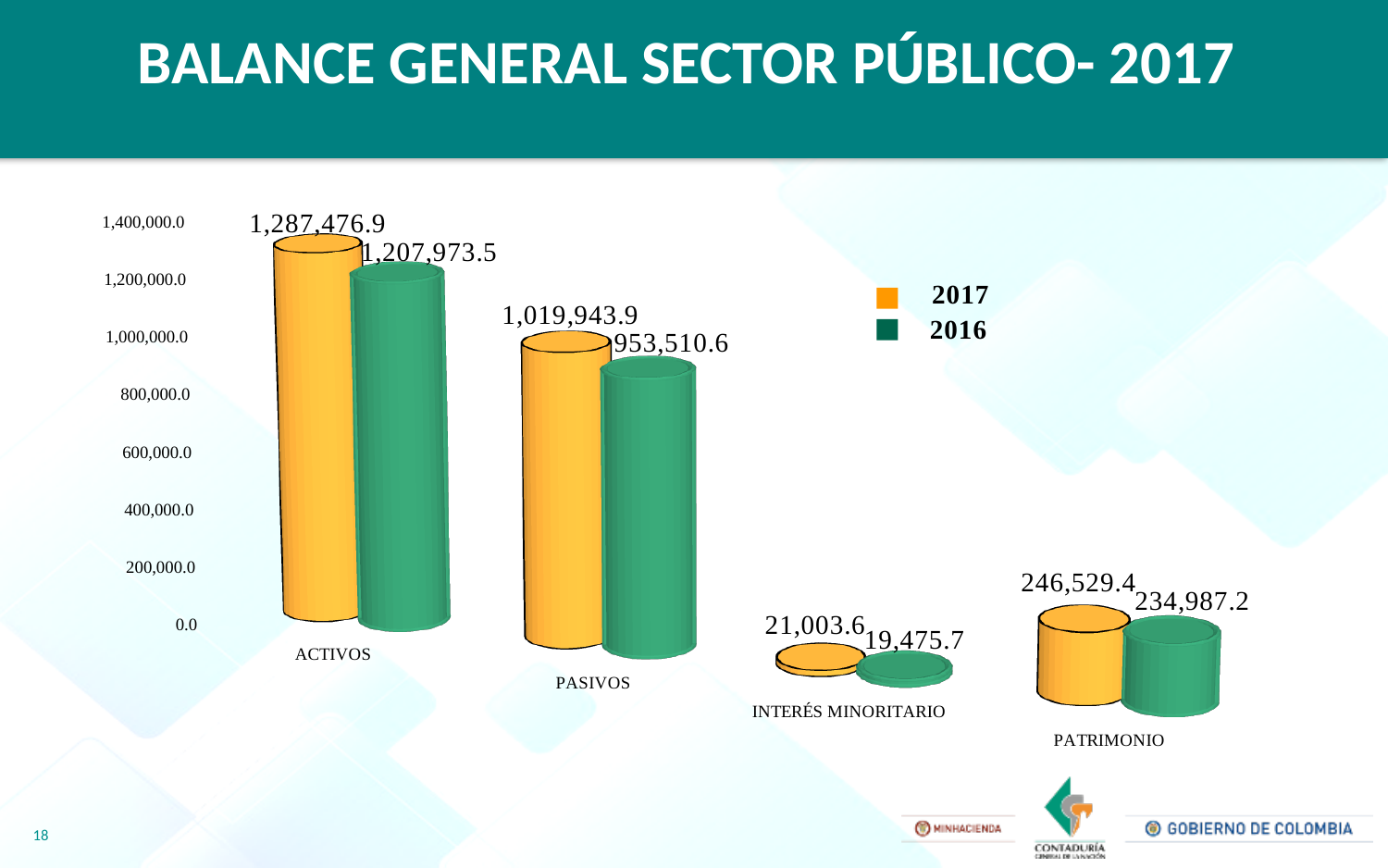
What kind of chart is shown on the slide? Bar chart What is the difference between the 2017 and 2016 values for ACTIVOS? 79,503.4 What is the value for PASIVOS in 2016? 953,510.6 How many series does the legend list? 2 What is the difference between the 2017 and 2016 values for PATRIMONIO? 11,542.2 Which category has the highest value in 2017? ACTIVOS How many categories are shown on the x axis? 4 What is the value for PATRIMONIO in 2017? 246,529.4 Which category has the lowest value in 2016? INTERÉS MINORITARIO Which is larger for PASIVOS, the 2017 value or the 2016 value? 2017 What is the value for INTERÉS MINORITARIO in 2016? 19,475.7 What is the value for ACTIVOS in 2017? 1,287,476.9